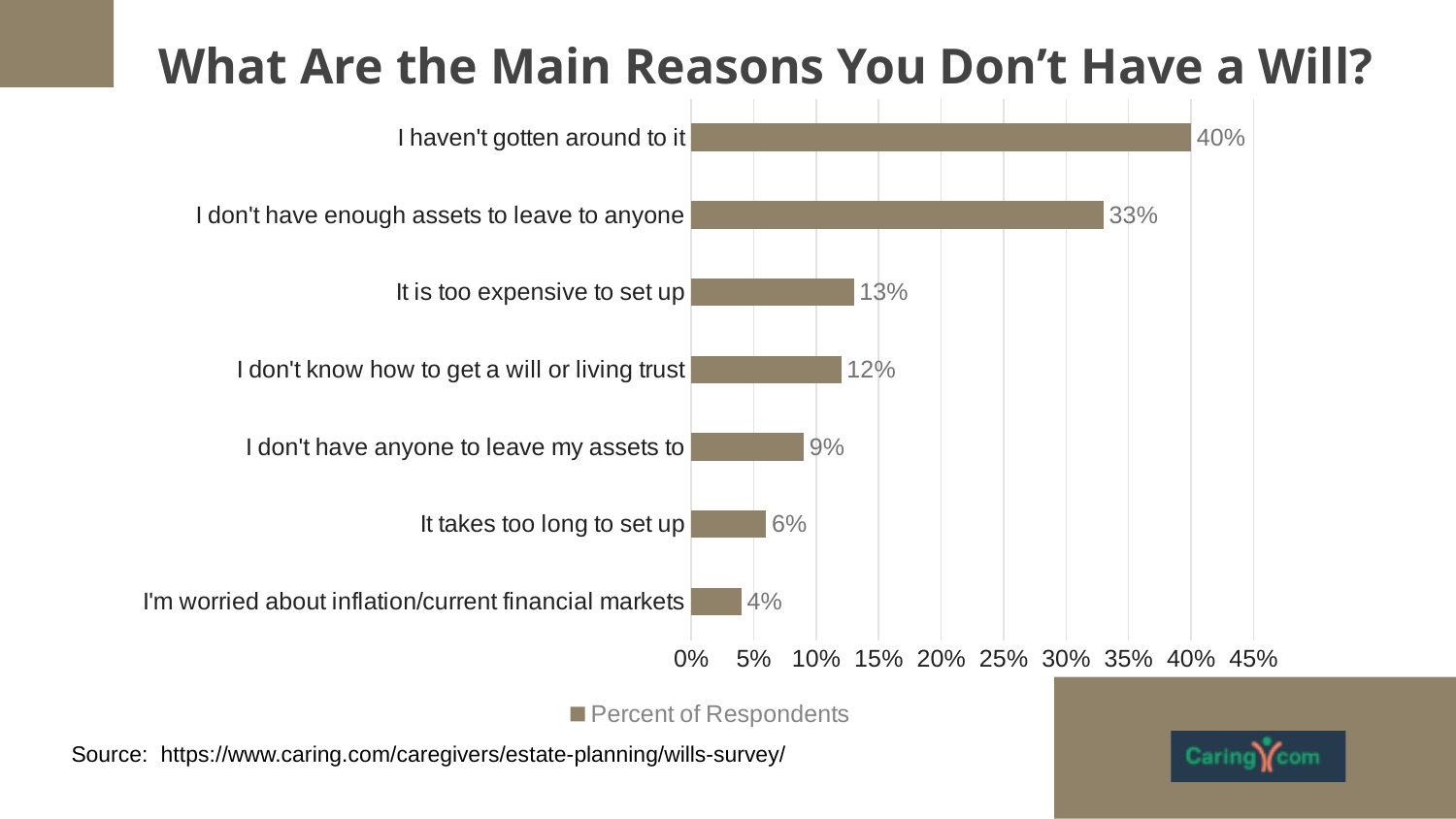
Is the value for "I don't have enough assets to leave to anyone" greater or less than 30%? greater What is the value for "It is too expensive to set up"? 13% Which is larger: "I don't have anyone to leave my assets to" or "It takes too long to set up"? I don't have anyone to leave my assets to Which reason has the lowest percentage of respondents? I'm worried about inflation/current financial markets What is the difference between "I haven't gotten around to it" and "I don't have enough assets to leave to anyone"? 7% What percentage of respondents said "I haven't gotten around to it"? 40% Which reason has the highest percentage of respondents? I haven't gotten around to it How many series does the legend list? 1 What is the legend entry for the series in the chart? Percent of Respondents What kind of chart is shown on the slide? Bar chart How many reasons are shown in the chart? 7 What percentage of respondents said "I'm worried about inflation/current financial markets"? 4%